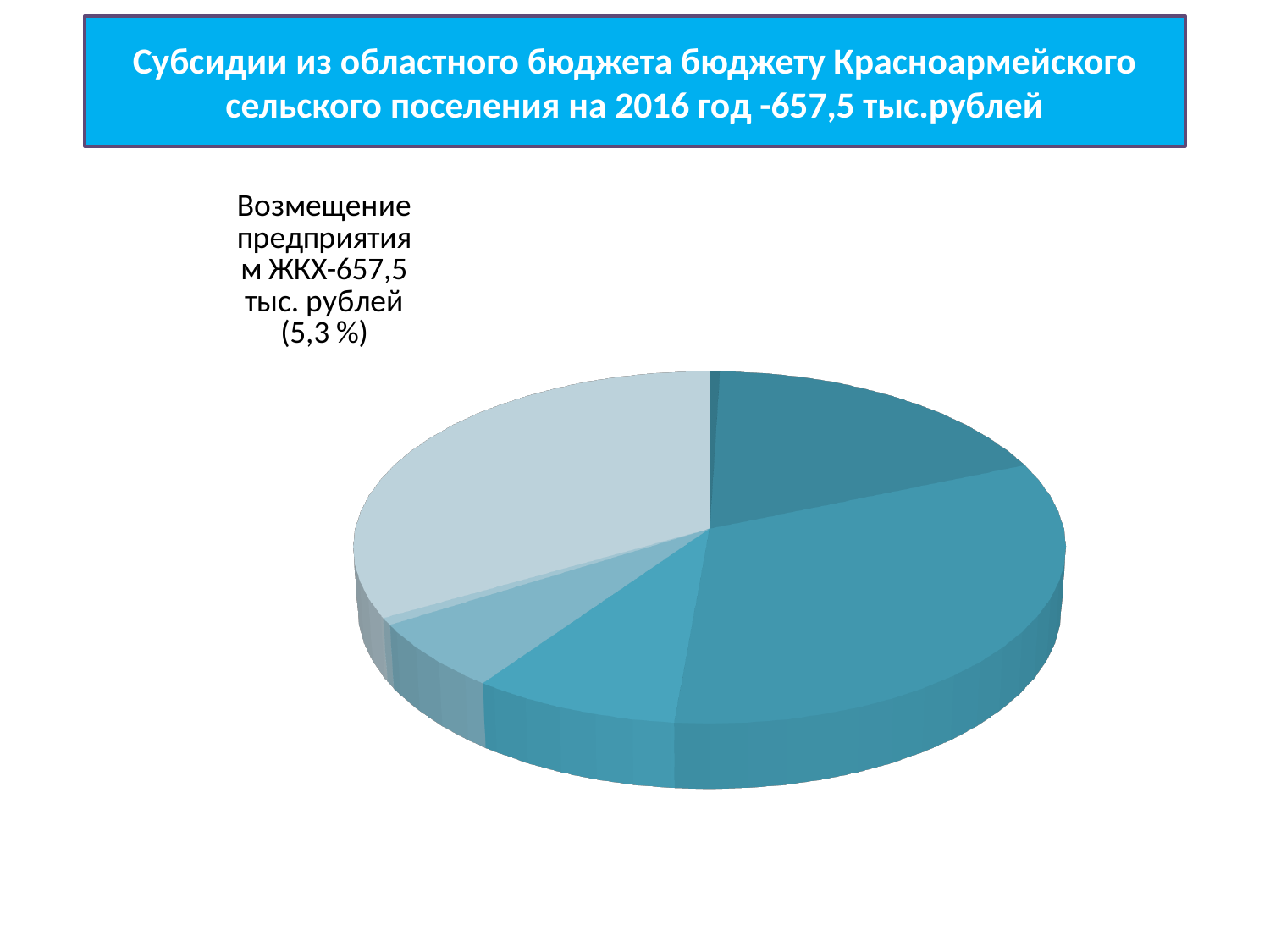
What amount in thousand rubles is shown in the data label for Возмещение предприятиям ЖКХ? 657,5 тыс. рублей Which category is named in the only data label on the pie chart? Возмещение предприятиям ЖКХ What is the title of the chart on the slide? Субсидии из областного бюджета бюджету Красноармейского сельского поселения на 2016 год -657,5 тыс.рублей What kind of chart is shown on the slide? pie chart According to the chart title, what is the total amount of subsidies from the regional budget for 2016? 657,5 тыс.рублей How many slices does the pie chart have? 5 What percentage is shown in the data label for Возмещение предприятиям ЖКХ? 5,3 %